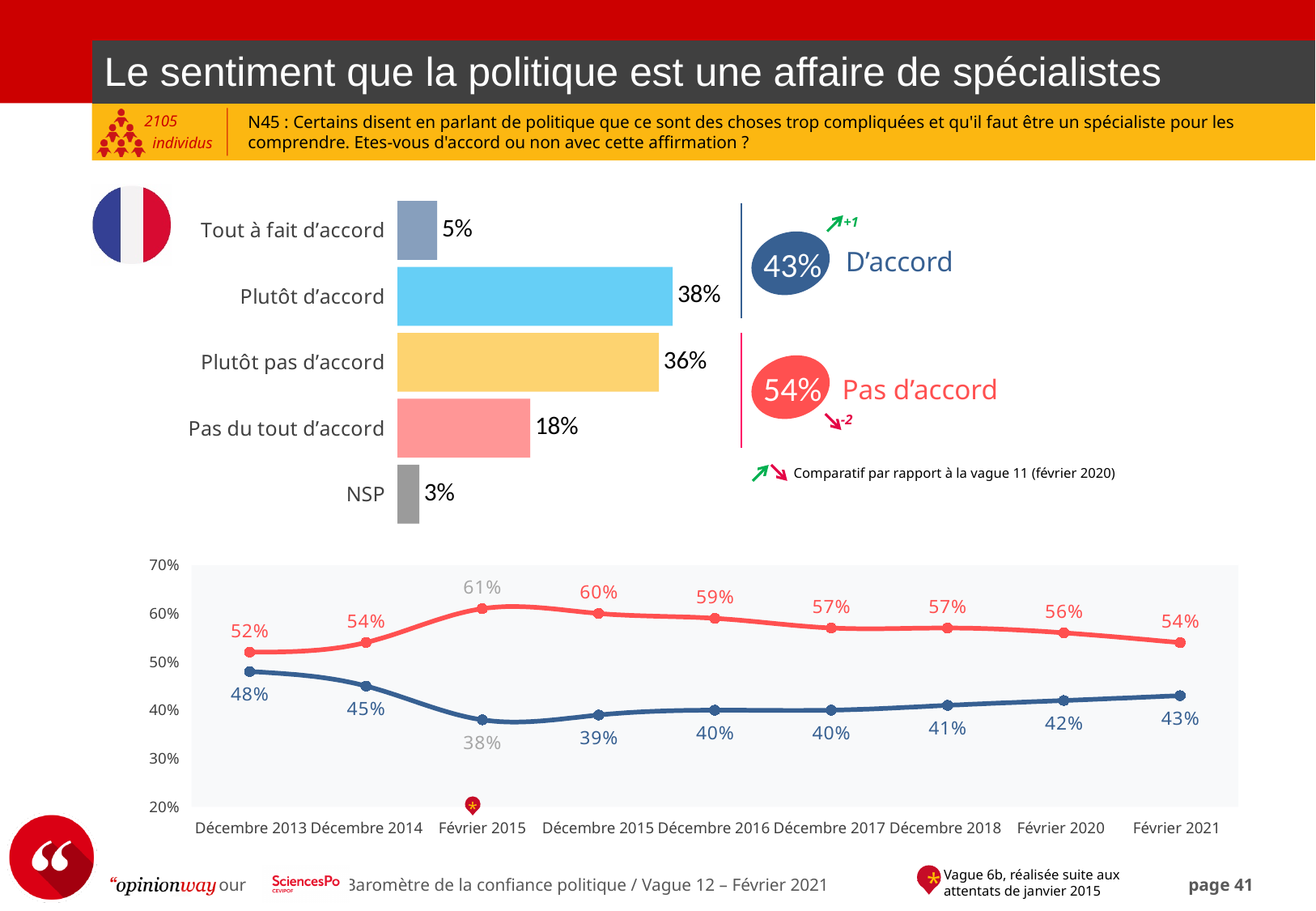
In the bottom line chart, what is the value of the blue line for Décembre 2013? 48% In the top bar chart, what is the value for "Plutôt d'accord"? 38% In the bottom line chart, does the blue line rise or fall from Février 2015 to Février 2021? Rise In the top bar chart, how many categories are shown? 5 In the top bar chart, what is the value for "Pas du tout d'accord"? 18% In the bottom line chart, how many time points are plotted along the x axis? 9 In the bottom line chart, what is the value of the red line for Février 2015? 61% What kind of chart is the top chart on the slide? Bar chart In the top bar chart, which category has the highest value? Plutôt d'accord In the top bar chart, which category has the lowest value? NSP In the top bar chart, what is the difference between "Plutôt pas d'accord" and "Tout à fait d'accord"? 31% In the bottom line chart, what is the difference between the red line and the blue line for Février 2021? 11%